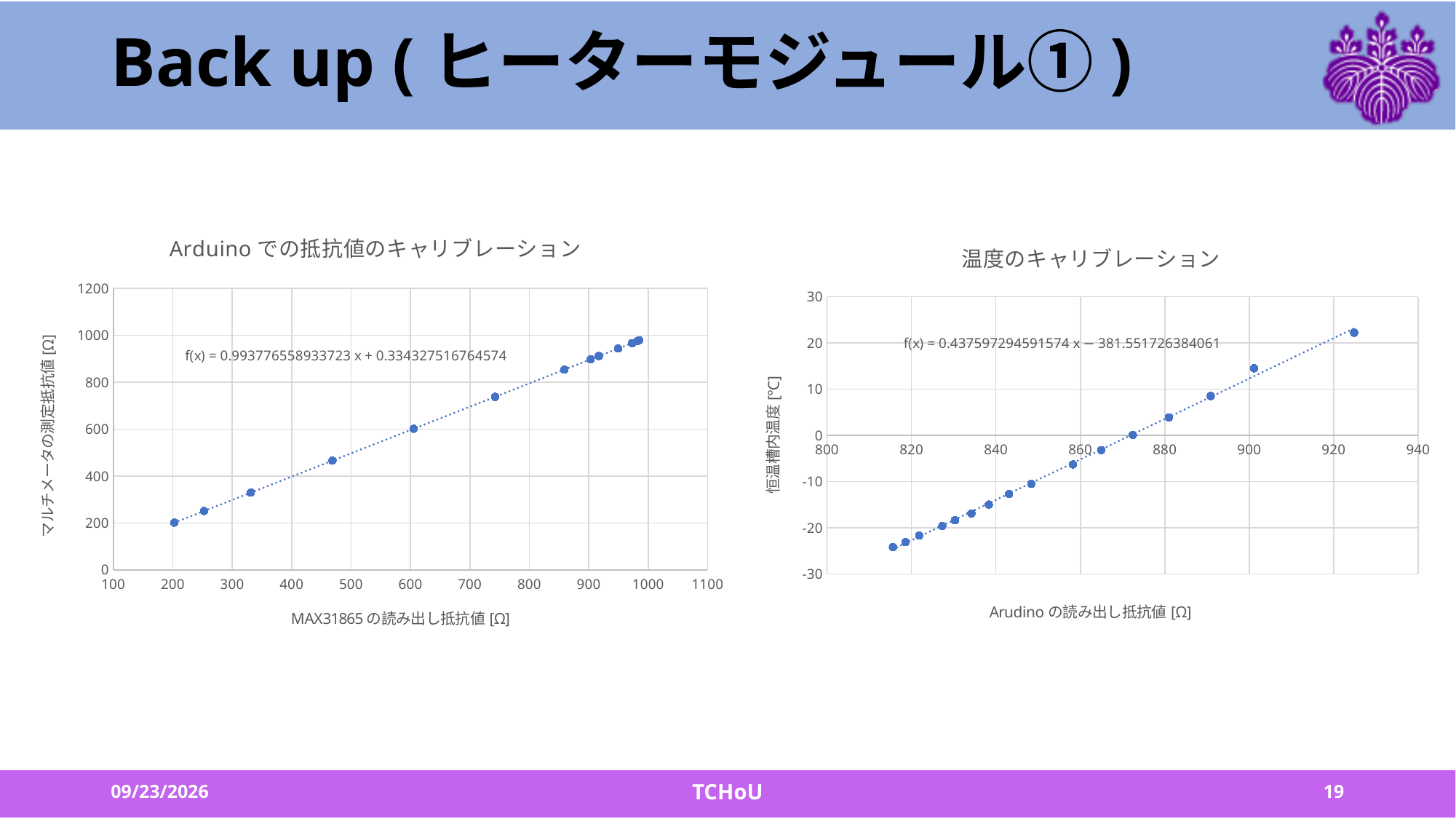
In the left chart 'Arduino での抵抗値のキャリブレーション', is the measured resistance for the point near 470 Ω on the x-axis greater or less than 600? less What is the trendline equation shown on the left chart 'Arduino での抵抗値のキャリブレーション'? f(x) = 0.993776558933723 x + 0.334327516764574 In the left chart 'Arduino での抵抗値のキャリブレーション', do the plotted values rise or fall as the x-axis value increases? rise What kind of chart is the right chart titled '温度のキャリブレーション'? scatter chart In the right chart '温度のキャリブレーション', is the temperature for the point near 900 Ω on the x-axis greater or less than 10? greater In the right chart '温度のキャリブレーション', is the temperature for the point near 860 Ω on the x-axis greater or less than 0? less What kind of chart is the left chart titled 'Arduino での抵抗値のキャリブレーション'? scatter chart What is the x-axis label of the right chart '温度のキャリブレーション'? Arudino の読み出し抵抗値 [Ω] In the right chart '温度のキャリブレーション', do the plotted values rise or fall as the x-axis value increases? rise